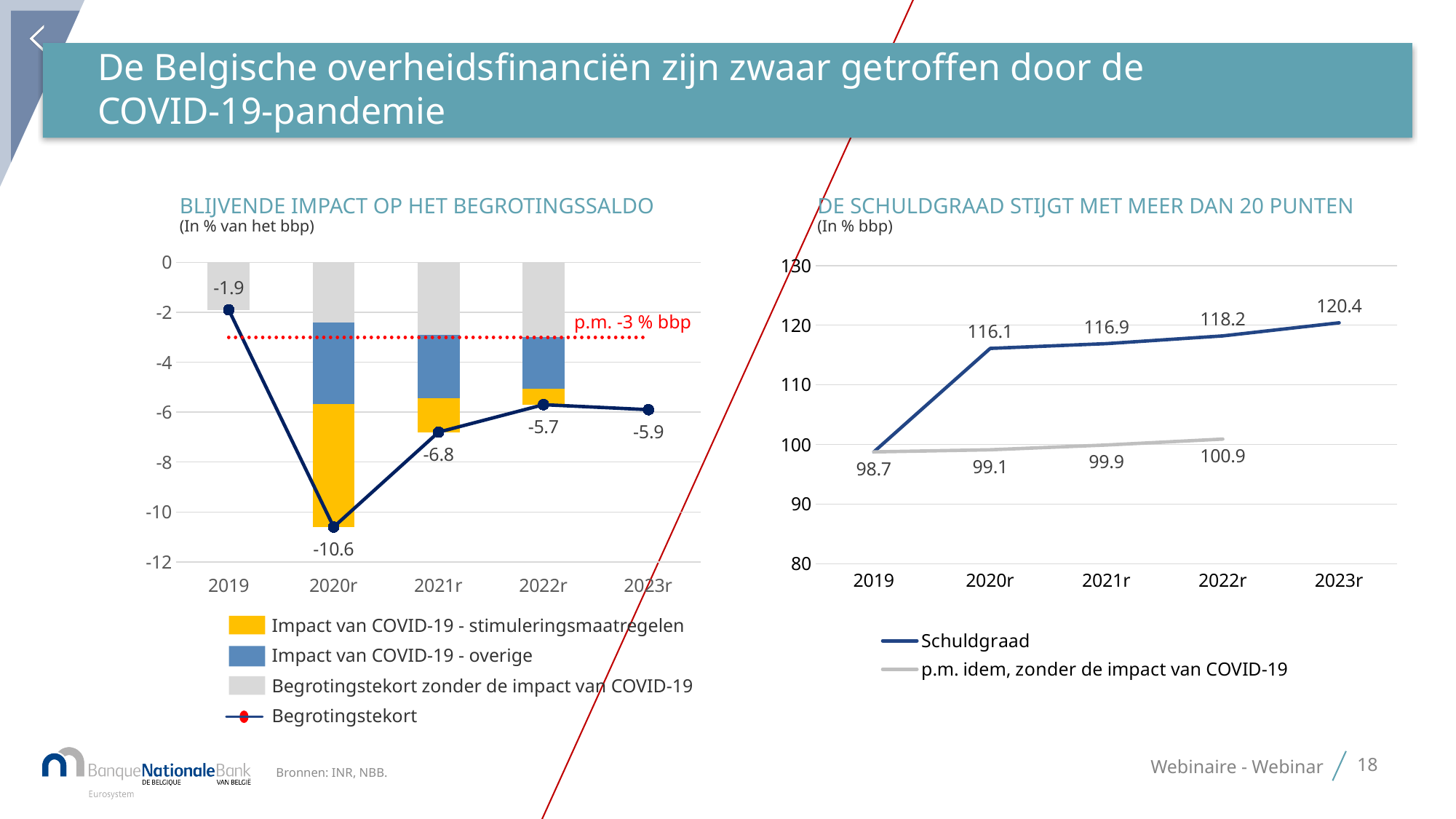
In the chart 'BLIJVENDE IMPACT OP HET BEGROTINGSSALDO', what value does the red dotted reference line indicate? p.m. -3 % bbp In the chart 'DE SCHULDGRAAD STIJGT MET MEER DAN 20 PUNTEN', does the Schuldgraad rise or fall from 2019 to 2023r? rise In the chart 'BLIJVENDE IMPACT OP HET BEGROTINGSSALDO', what is the difference between the Begrotingstekort in 2019 (-1.9) and in 2023r (-5.9)? 4 In the chart 'BLIJVENDE IMPACT OP HET BEGROTINGSSALDO', in which year is the Begrotingstekort lowest? 2020r How many years are shown on the x axis of the chart 'BLIJVENDE IMPACT OP HET BEGROTINGSSALDO'? 5 In the chart 'BLIJVENDE IMPACT OP HET BEGROTINGSSALDO', what is the Begrotingstekort value for 2020r? -10.6 In the chart 'DE SCHULDGRAAD STIJGT MET MEER DAN 20 PUNTEN', what is the Schuldgraad value for 2023r? 120.4 In the chart 'DE SCHULDGRAAD STIJGT MET MEER DAN 20 PUNTEN', what is the value of 'p.m. idem, zonder de impact van COVID-19' for 2022r? 100.9 In the chart 'DE SCHULDGRAAD STIJGT MET MEER DAN 20 PUNTEN', by how much does the Schuldgraad in 2023r (120.4) exceed the value in 2019 (98.7)? 21.7 In the chart 'DE SCHULDGRAAD STIJGT MET MEER DAN 20 PUNTEN', in which year is the Schuldgraad highest? 2023r How many entries does the legend of the chart 'BLIJVENDE IMPACT OP HET BEGROTINGSSALDO' list? 4 What kind of chart is 'DE SCHULDGRAAD STIJGT MET MEER DAN 20 PUNTEN'? line chart